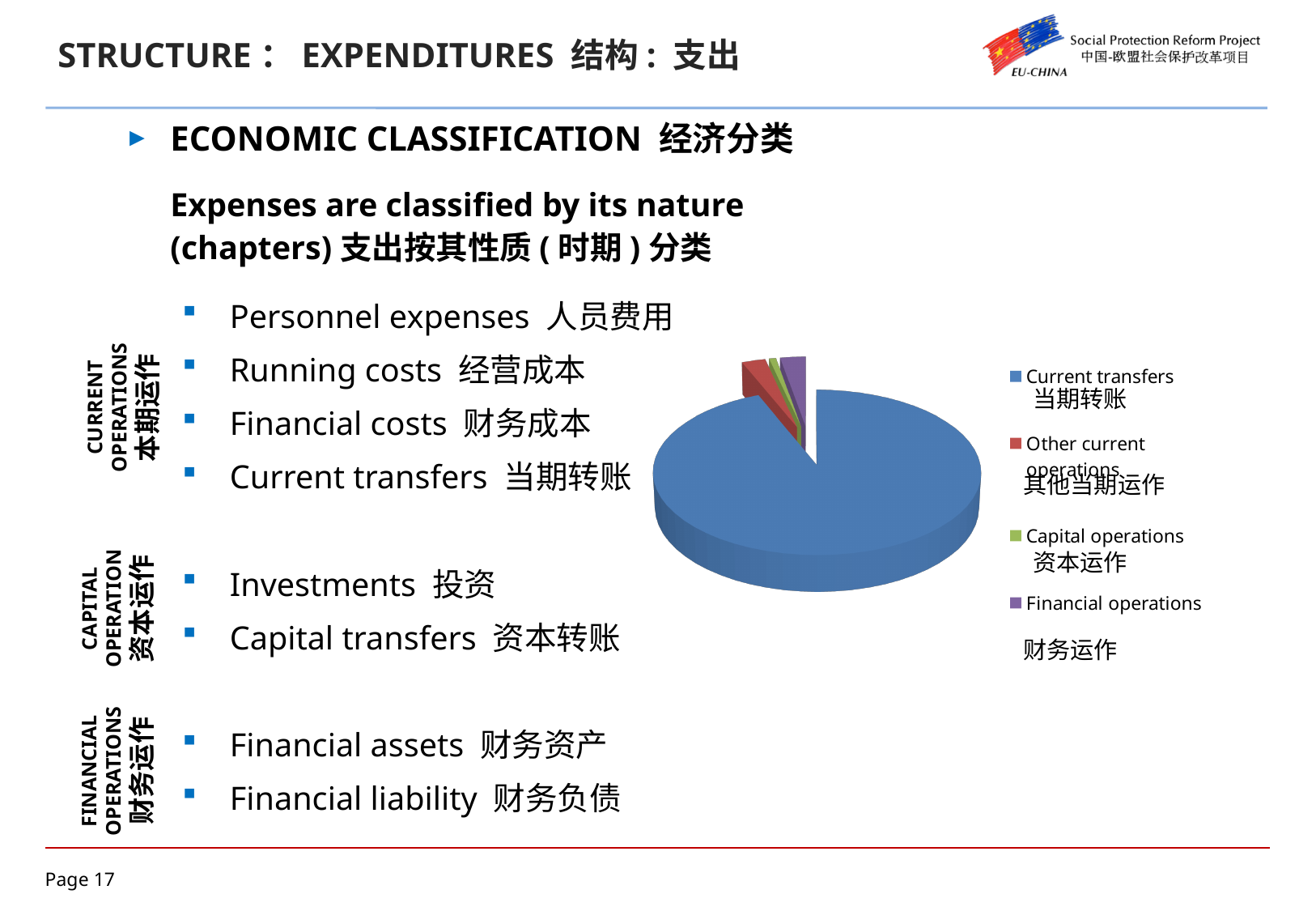
Which slice is larger in the pie chart, Current transfers or Financial operations? Current transfers How many slices does the pie chart have? 4 What colour is the Current transfers slice in the pie chart? Blue Which category has the largest slice in the pie chart? Current transfers How many entries does the pie chart's legend list? 4 Which slice is larger in the pie chart, Other current operations or Capital operations? Other current operations Which legend entry in the pie chart is shown in purple? Financial operations What kind of chart is shown on the slide? Pie chart Which slice is larger in the pie chart, Current transfers or Other current operations? Current transfers